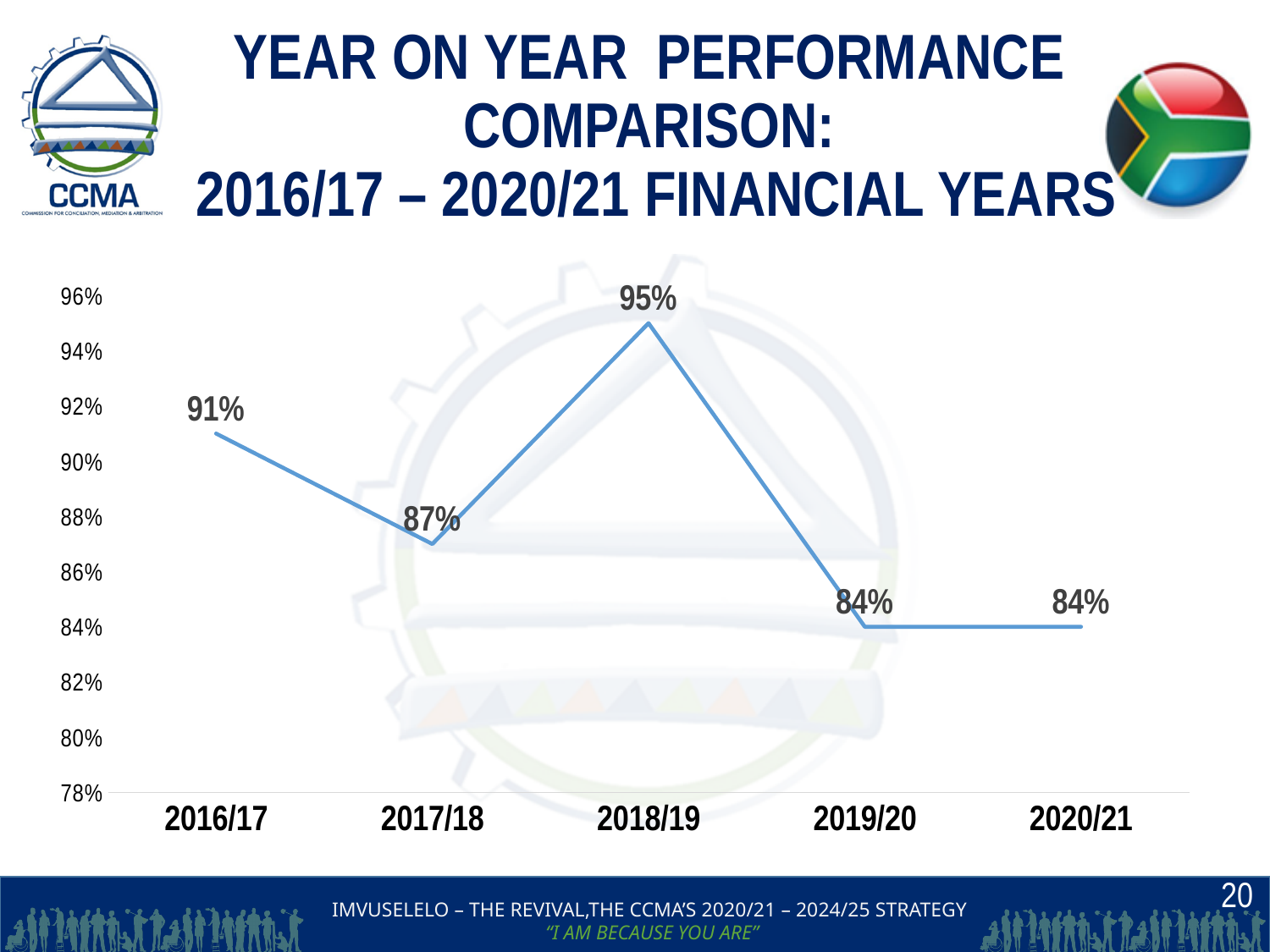
What kind of chart is shown on the slide? line chart Is the value for 2018/19 greater or less than 90%? greater Do the values rise or fall from 2018/19 to 2019/20? fall What is the value for 2019/20? 84% What is the value for 2016/17? 91% Which financial year has the highest value? 2018/19 What is the difference between the values for 2016/17 and 2020/21? 7% Which is larger, the value for 2016/17 or the value for 2017/18? 2016/17 What is the value for 2017/18? 87% What is the difference between the values for 2018/19 and 2017/18? 8% How many financial years are plotted on the chart? 5 What is the value for 2018/19? 95%